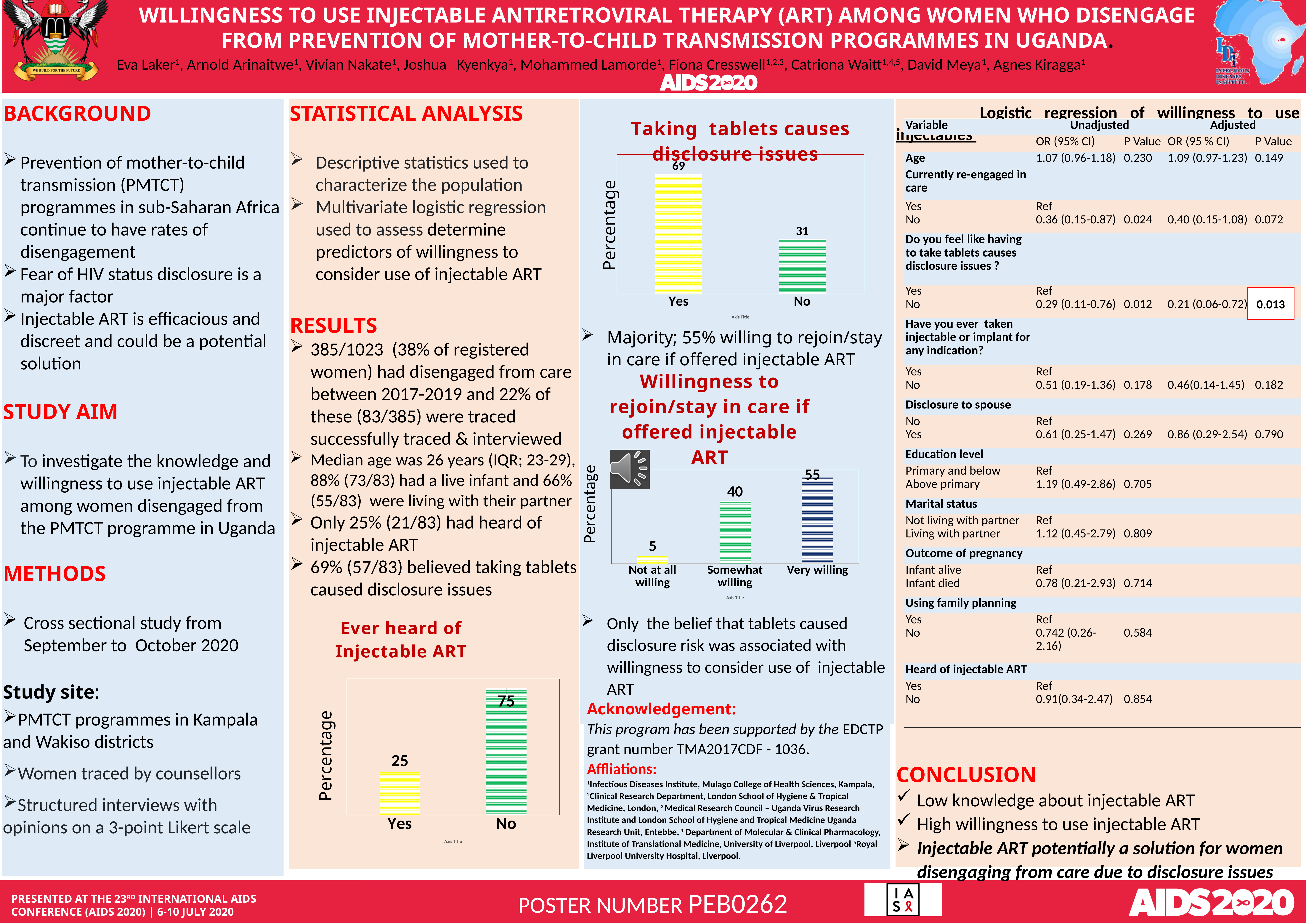
In the 'Taking tablets causes disclosure issues' chart, what is the value for Yes? 69 In the 'Willingness to rejoin/stay in care if offered injectable ART' chart, what is the difference between Very willing and Somewhat willing? 15 In the 'Taking tablets causes disclosure issues' chart, what is the difference between the Yes and No values? 38 In the 'Willingness to rejoin/stay in care if offered injectable ART' chart, which category has the lowest value? Not at all willing In the 'Ever heard of Injectable ART' chart, what is the value for No? 75 In the 'Ever heard of Injectable ART' chart, what is the value for Yes? 25 In the 'Willingness to rejoin/stay in care if offered injectable ART' chart, how many categories are shown? 3 In the 'Willingness to rejoin/stay in care if offered injectable ART' chart, which category has the highest value? Very willing What type of chart is the 'Ever heard of Injectable ART' chart? Bar chart In the 'Taking tablets causes disclosure issues' chart, which category has the lowest value? No In the 'Willingness to rejoin/stay in care if offered injectable ART' chart, what is the value for Somewhat willing? 40 In the 'Ever heard of Injectable ART' chart, what is the difference between the No and Yes values? 50